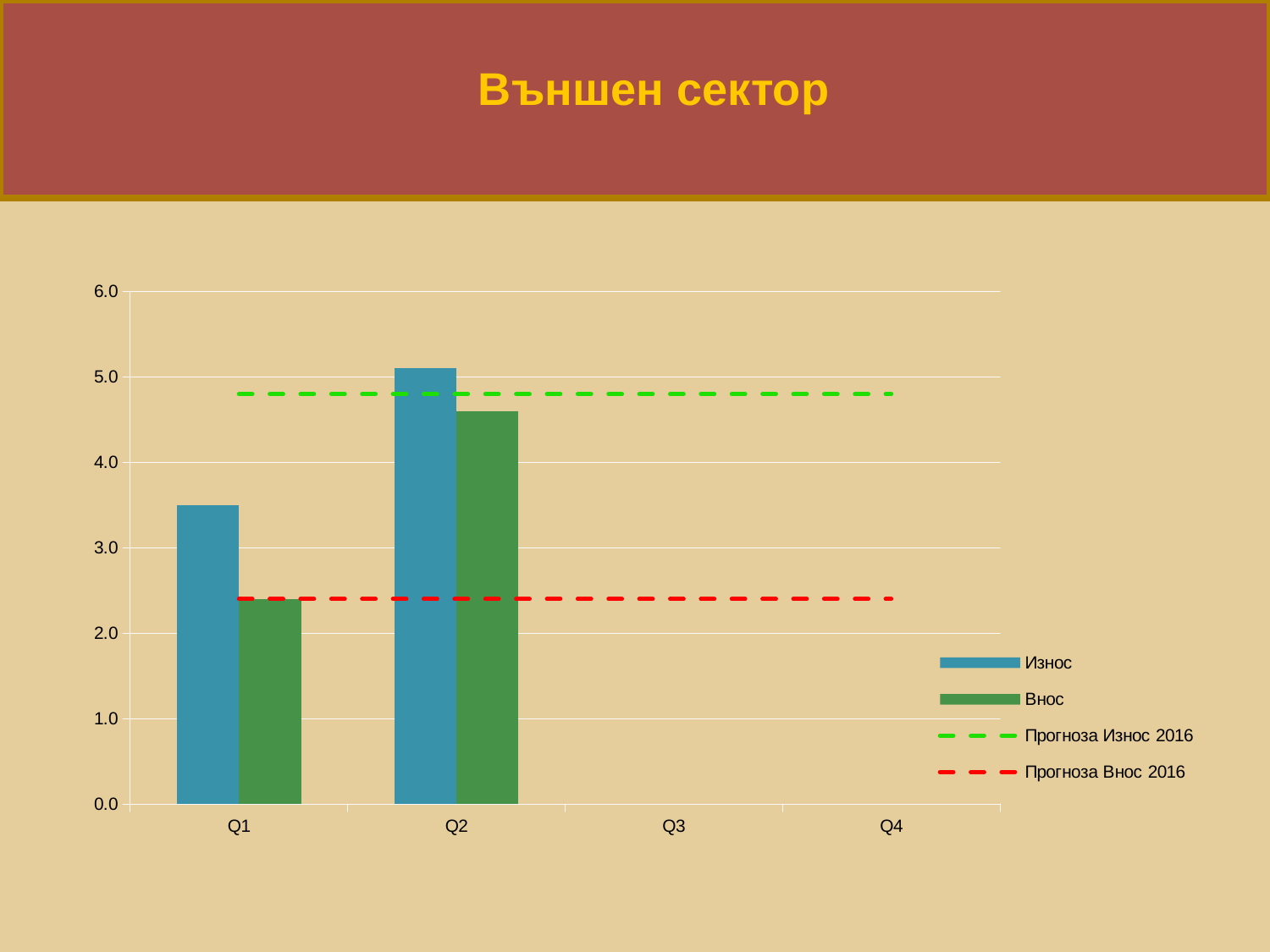
Is the value for Внос in Q1 greater or less than 3.0? less What is the title of the slide? Външен сектор Is the value for Износ in Q1 greater or less than 4.0? less Does the Износ value rise or fall from Q1 to Q2? rise Which quarter has the higher Износ value, Q1 or Q2? Q2 How many quarters are labelled on the x axis? 4 How many entries does the legend list? 4 Is the value for Износ in Q1 greater or less than 3.0? greater What colour are the Износ bars? Blue In Q1, which is larger, Износ or Внос? Износ What kind of chart is shown on the slide? Combination bar and line chart